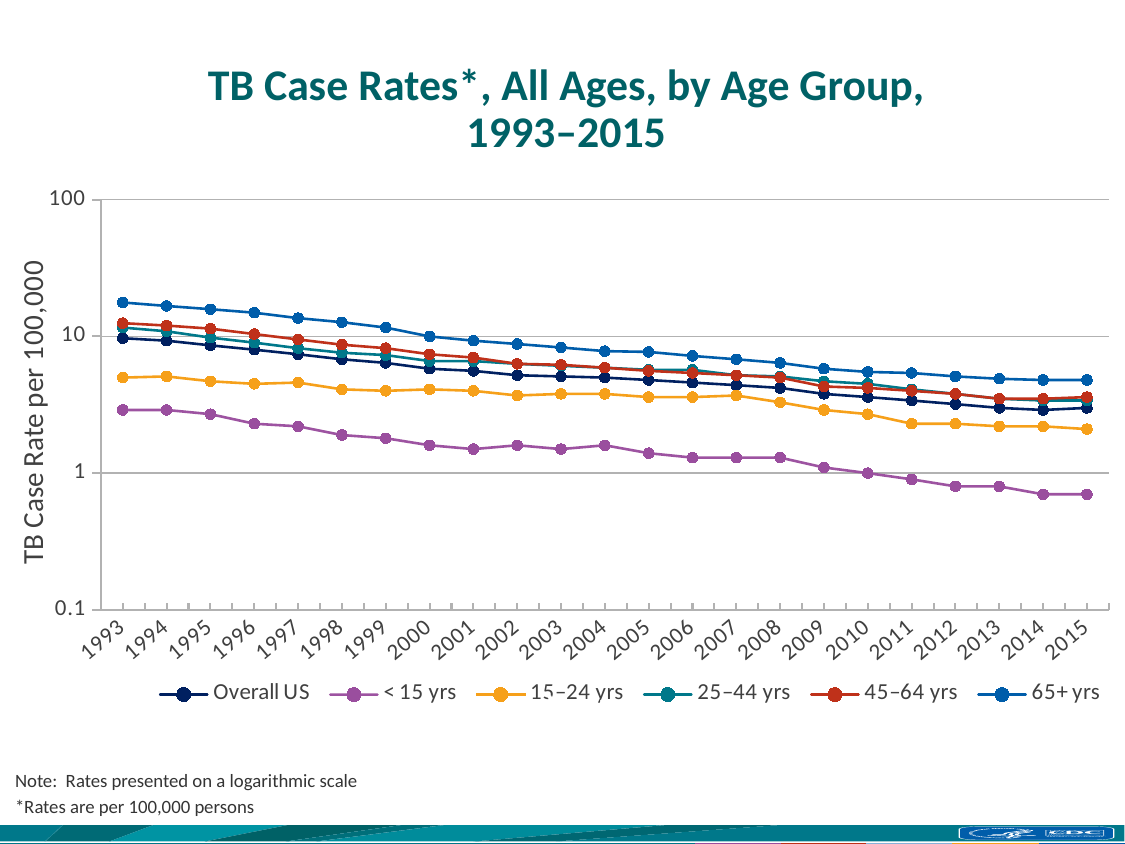
Which age group has the lowest TB case rate in 2015? < 15 yrs How many series does the legend list? 6 Is the TB case rate for the 65+ yrs group in 2015 greater or less than 10? less According to the note on the slide, what kind of scale are the rates presented on? logarithmic scale Do TB case rates for the 65+ yrs group rise or fall from 1993 to 2015? fall Which age group has the highest TB case rate in 1993? 65+ yrs What kind of chart is shown on the slide? line chart Is the TB case rate for the 15–24 yrs group in 1993 greater or less than 10? less How many years are plotted along the x axis? 23 In 2015, which has the higher TB case rate: the 65+ yrs group or the < 15 yrs group? 65+ yrs Is the TB case rate for the < 15 yrs group in 2015 greater or less than 1? less